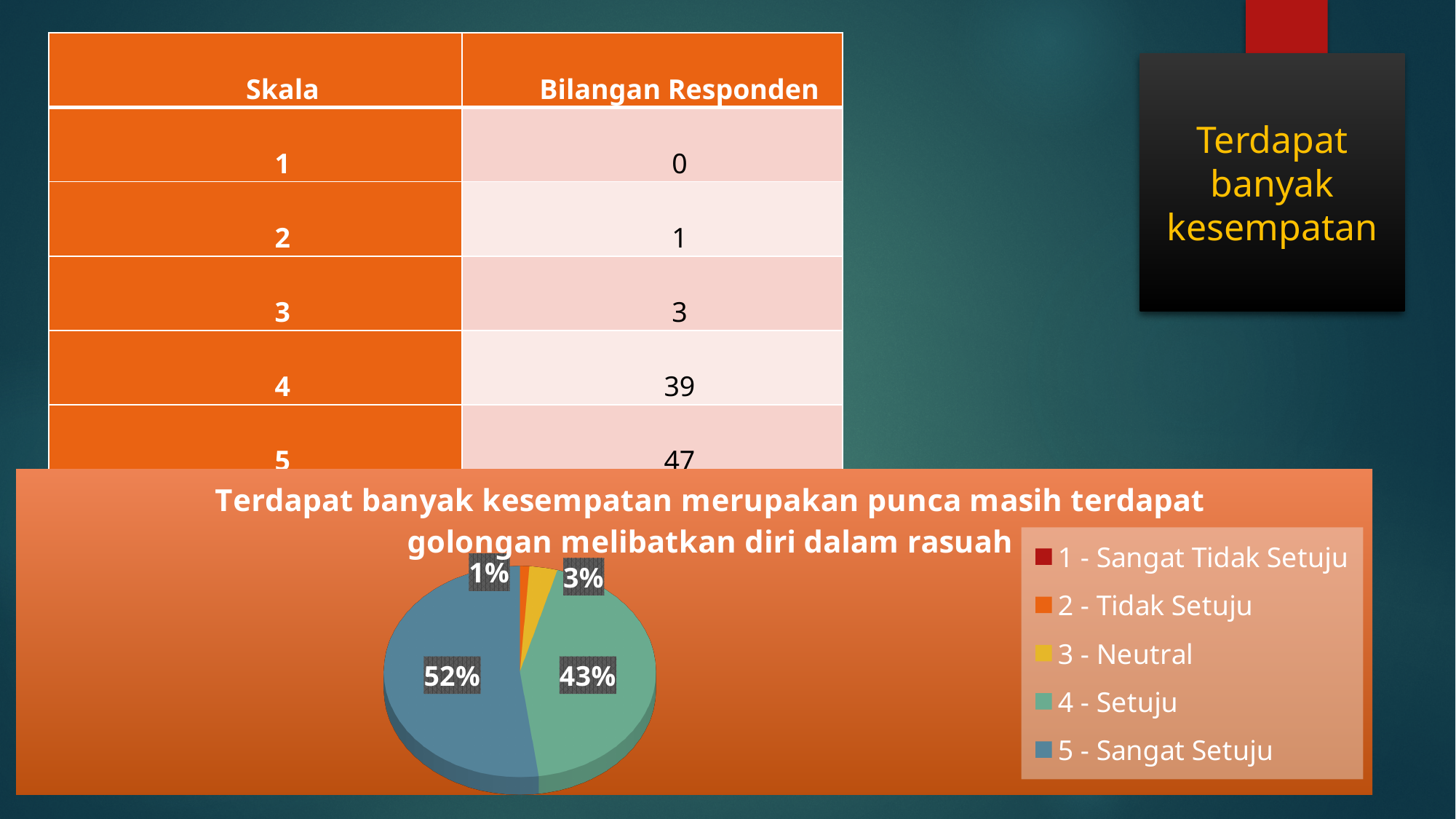
What kind of chart is shown on the slide? pie chart What percentage is shown for the '3 - Neutral' slice of the pie chart? 3% What percentage is shown for the '2 - Tidak Setuju' slice of the pie chart? 1% Which category has the largest slice in the pie chart? 5 - Sangat Setuju Which slice is larger in the pie chart: '3 - Neutral' or '2 - Tidak Setuju'? 3 - Neutral How many entries does the legend of the pie chart list? 5 What percentage is shown for the '4 - Setuju' slice of the pie chart? 43% What percentage is shown for the '5 - Sangat Setuju' slice of the pie chart? 52% What colour is the '5 - Sangat Setuju' slice in the pie chart? blue What is the difference in percentage points between the '5 - Sangat Setuju' and '4 - Setuju' slices? 9 Which of the labelled slices in the pie chart is the smallest? 2 - Tidak Setuju What is the title of the pie chart? Terdapat banyak kesempatan merupakan punca masih terdapat golongan melibatkan diri dalam rasuah